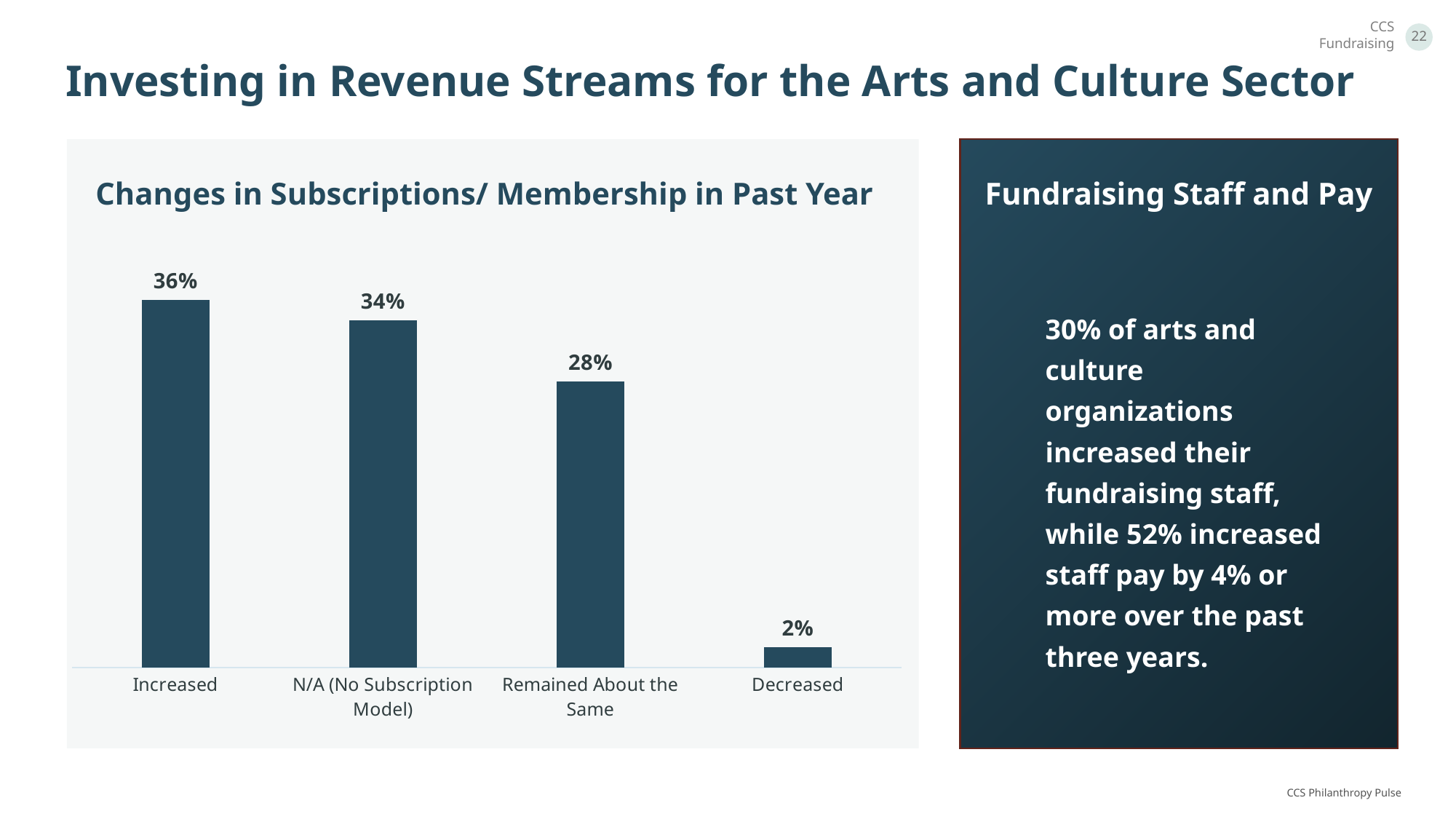
What is the difference between the values for Increased and Remained About the Same? 8% Which is larger, the value for Remained About the Same or the value for Decreased? Remained About the Same What is the title of the chart? Changes in Subscriptions/ Membership in Past Year Which category has the highest value? Increased What is the value for Remained About the Same? 28% What is the value for N/A (No Subscription Model)? 34% What is the value for Decreased? 2% What is the value for Increased? 36% What kind of chart is shown on the slide? Bar chart What is the difference between the values for N/A (No Subscription Model) and Decreased? 32% How many categories are shown in the chart? 4 Which category has the lowest value? Decreased